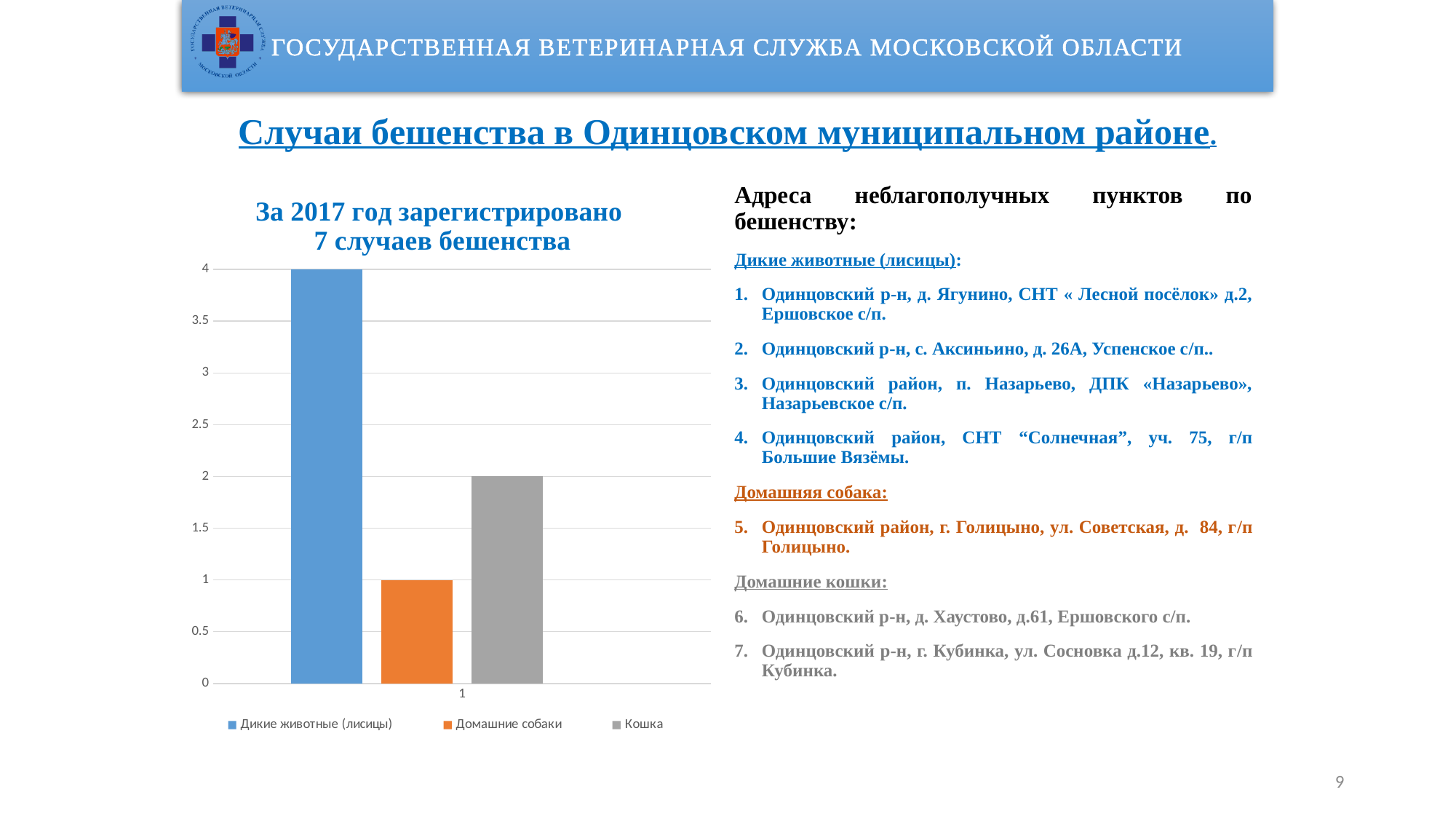
Is the value for Дикие животные (лисицы) greater or less than 3? greater Which series has the lowest value? Домашние собаки What is the value for Домашние собаки? 1 What kind of chart is shown on the slide? bar chart What is the difference between the values for Кошка and Домашние собаки? 1 Which is larger, the value for Кошка or the value for Домашние собаки? Кошка How many series does the legend list? 3 Which series has the highest value? Дикие животные (лисицы) What is the difference between the values for Дикие животные (лисицы) and Кошка? 2 What is the title of the chart? За 2017 год зарегистрировано 7 случаев бешенства What is the value for Кошка? 2 What is the value for Дикие животные (лисицы)? 4